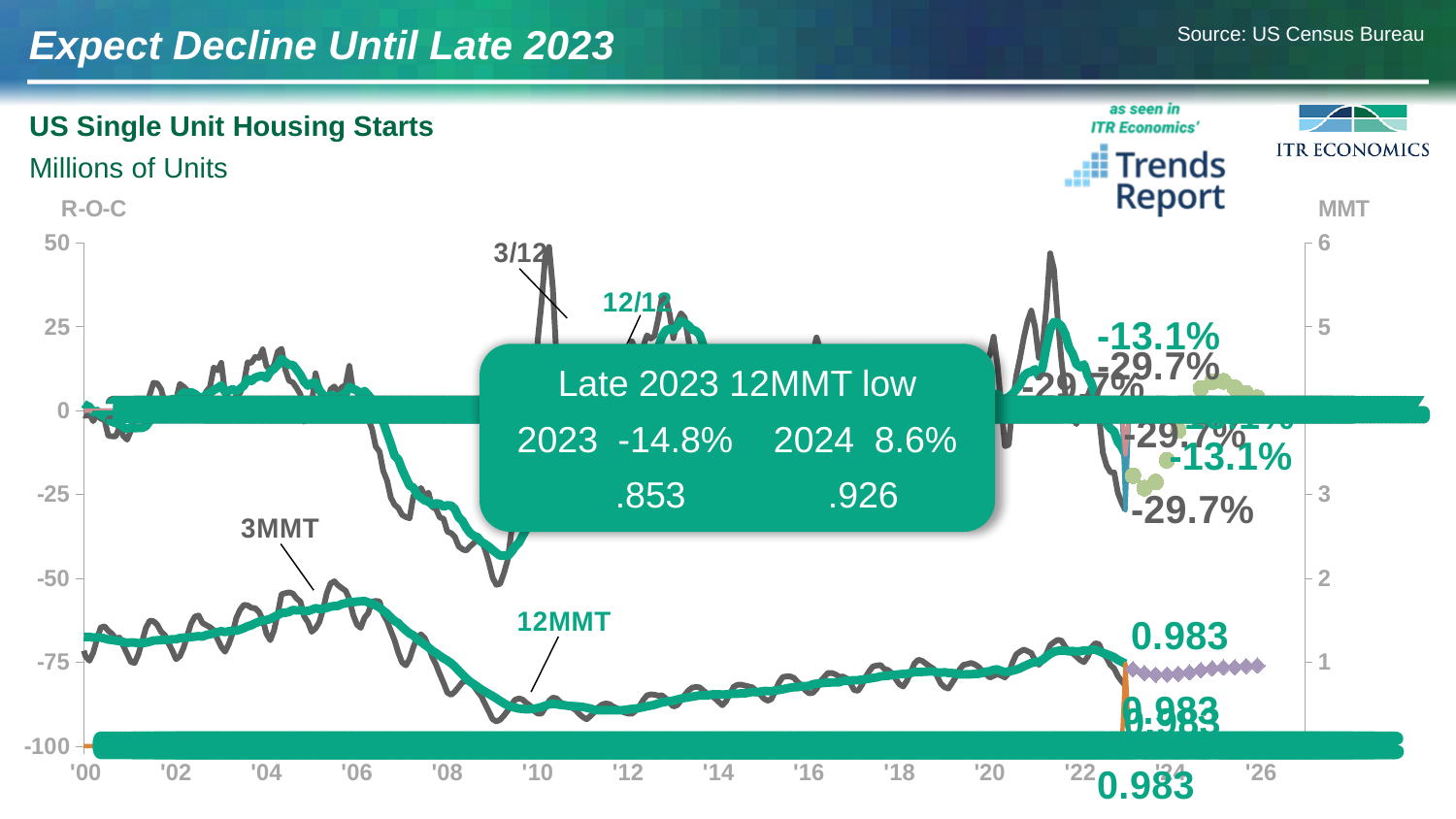
What is the forecast rate of change for 2023 shown in the callout box? -14.8% What 12MMT value is given for 2024 in the callout box? .926 How many labeled data series (3MMT, 12MMT, 3/12, 12/12) are plotted on the chart? 4 What is the difference between the 2024 and 2023 12MMT values shown in the callout box? .073 Is the 12/12 rate-of-change value around '09 greater or less than -25? less Which year has the higher 12MMT value in the callout box, 2023 or 2024? 2024 What 12MMT value is given for 2023 in the callout box? .853 Does the 12MMT line rise or fall between '10 and '22? rise What kind of chart is shown on the slide? line chart What is the highest value shown on the left R-O-C axis? 50 What is the title of the chart? US Single Unit Housing Starts What is the forecast rate of change for 2024 shown in the callout box? 8.6%